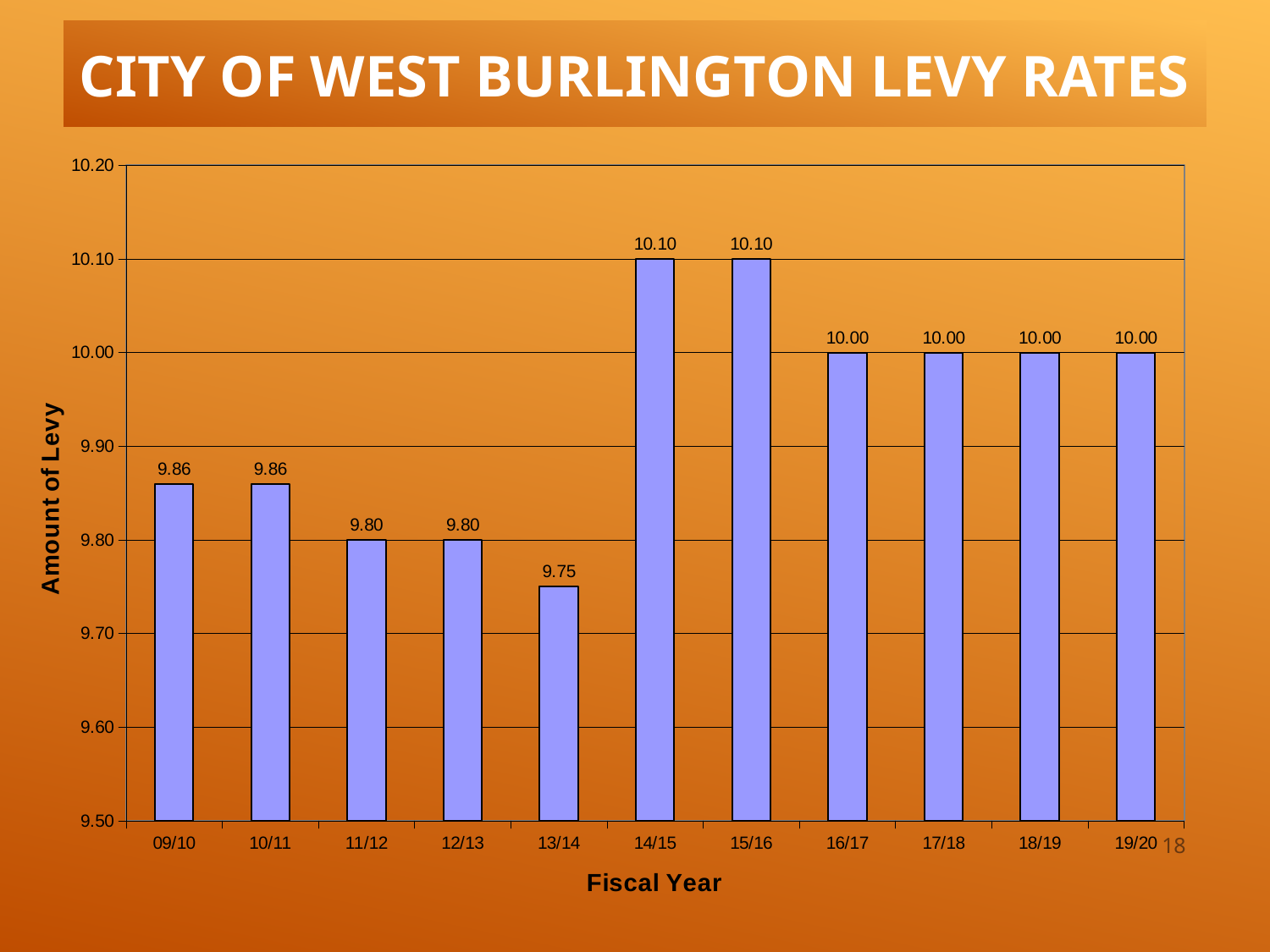
What kind of chart is shown on the slide? bar chart How many fiscal years are shown on the chart? 11 Is the levy rate for 12/13 greater or less than 9.90? less Which fiscal year has the lowest levy rate? 13/14 What is the label of the vertical axis? Amount of Levy What is the levy rate for fiscal year 14/15? 10.10 Does the levy rate rise or fall from 09/10 to 13/14? fall Which is larger, the levy rate for 10/11 or the levy rate for 16/17? 16/17 What is the levy rate for fiscal year 09/10? 9.86 What is the difference between the levy rate in 14/15 and the levy rate in 13/14? 0.35 What is the levy rate for fiscal year 13/14? 9.75 What is the difference between the levy rate in 09/10 and the levy rate in 11/12? 0.06